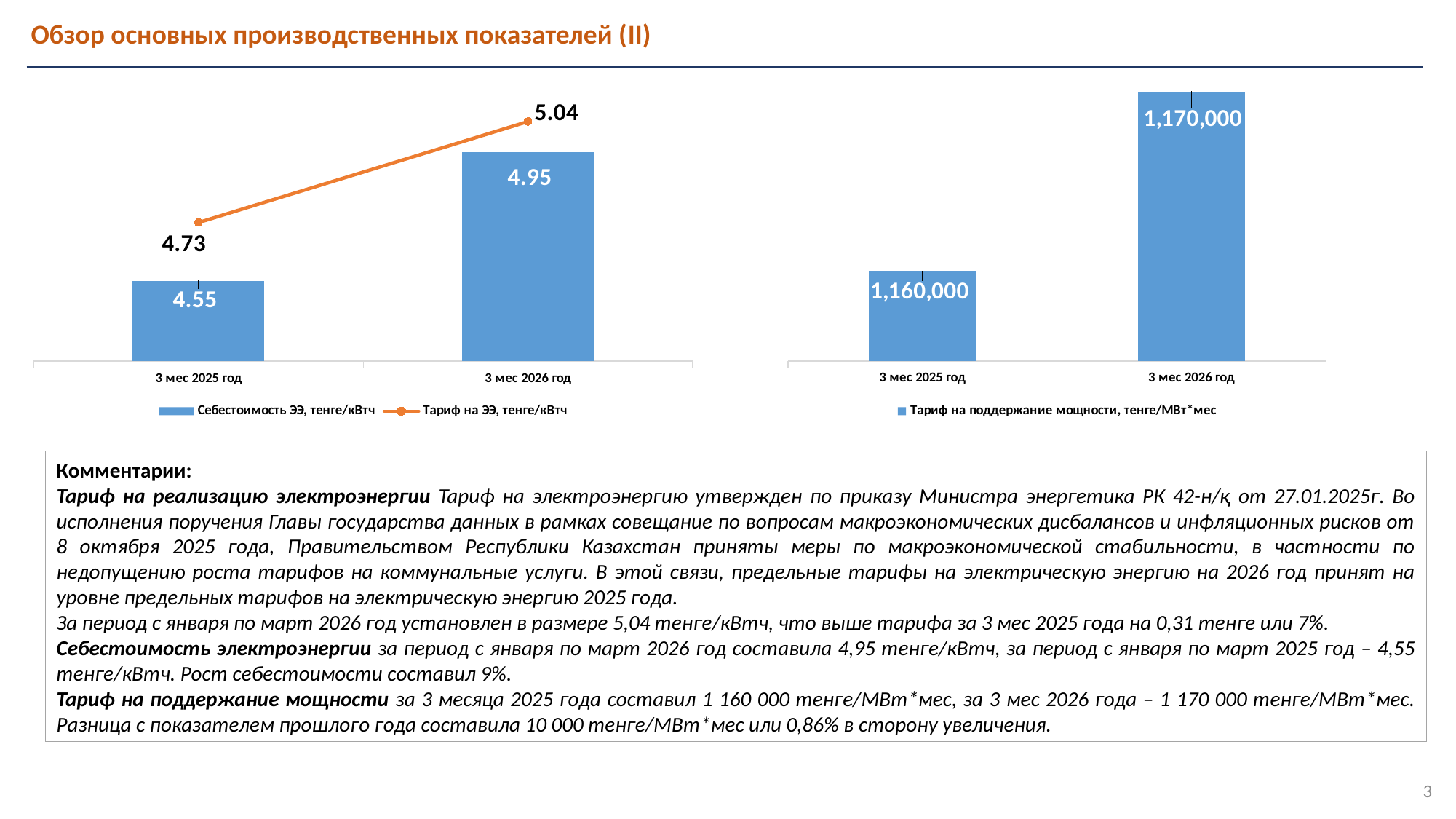
In the left chart, which is larger for 3 мес 2026 год: Себестоимость ЭЭ or Тариф на ЭЭ? Тариф на ЭЭ In the right chart, what is the value of Тариф на поддержание мощности for 3 мес 2026 год? 1,170,000 In the left chart, what is the value of Тариф на ЭЭ, тенге/кВтч for 3 мес 2025 год? 4.73 In the left chart, what is the value of Себестоимость ЭЭ, тенге/кВтч for 3 мес 2026 год? 4.95 In the left chart, how many series does the legend list? 2 In the left chart, what is the difference between the Тариф на ЭЭ values for 3 мес 2026 год and 3 мес 2025 год? 0.31 What type of chart is the right chart? bar chart In the right chart, what is the value of Тариф на поддержание мощности for 3 мес 2025 год? 1,160,000 In the right chart, what is the difference between the values for 3 мес 2026 год and 3 мес 2025 год? 10,000 In the left chart, what is the value of Себестоимость ЭЭ, тенге/кВтч for 3 мес 2025 год? 4.55 In the left chart, does Себестоимость ЭЭ rise or fall from 3 мес 2025 год to 3 мес 2026 год? rise In the right chart, which category has the highest value? 3 мес 2026 год